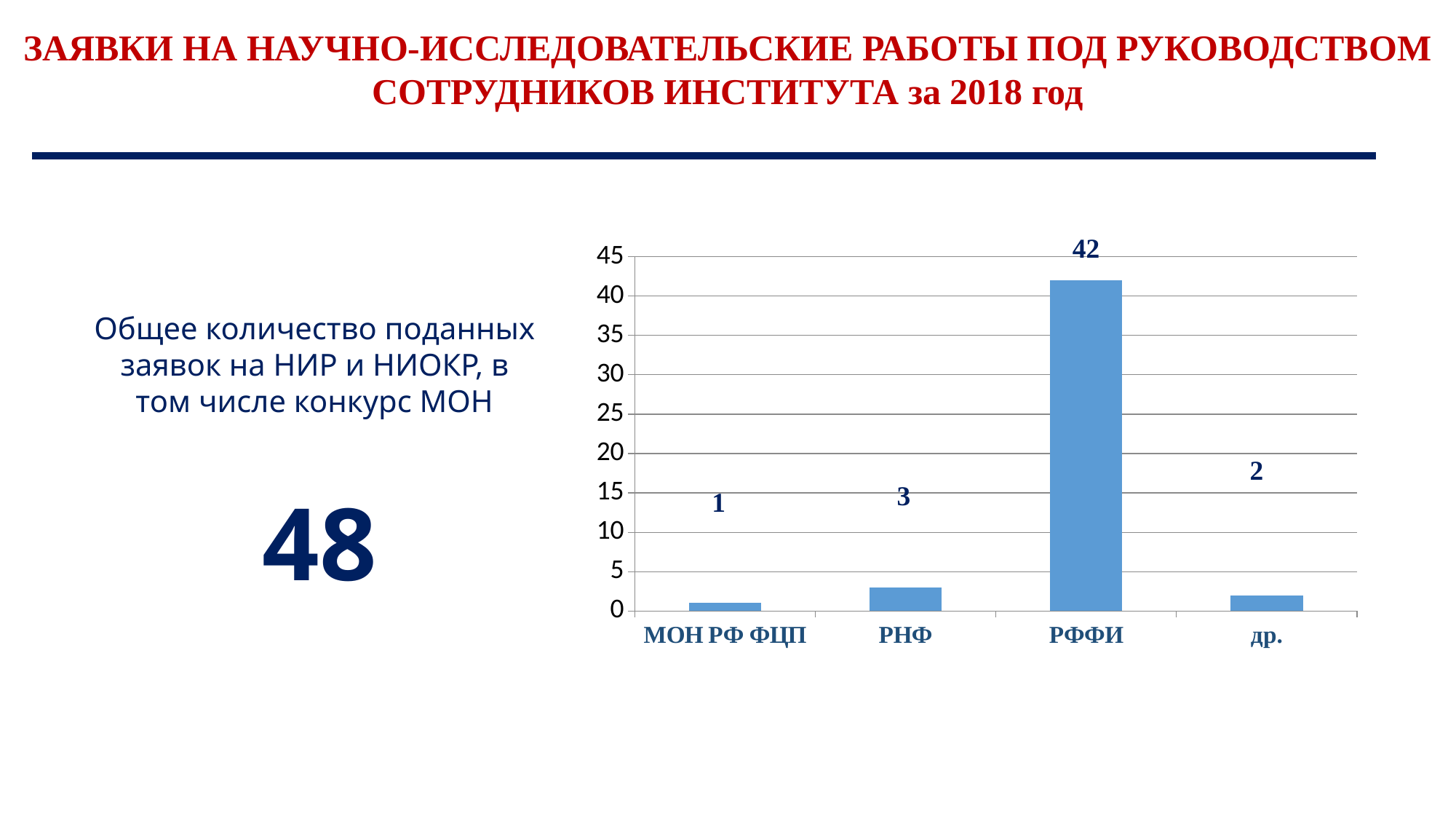
Which category has the lowest value? МОН РФ ФЦП What is the value for др.? 2 How many categories are shown on the x axis? 4 What is the value for РФФИ? 42 Is the value for РФФИ greater or less than 40? greater What is the difference between the values for РФФИ and РНФ? 39 What is the value for РНФ? 3 What kind of chart is shown on the slide? bar chart Which is larger, the value for РНФ or the value for др.? РНФ What is the value for МОН РФ ФЦП? 1 Which category has the highest value? РФФИ What is the total number of applications stated in the text to the left of the chart? 48